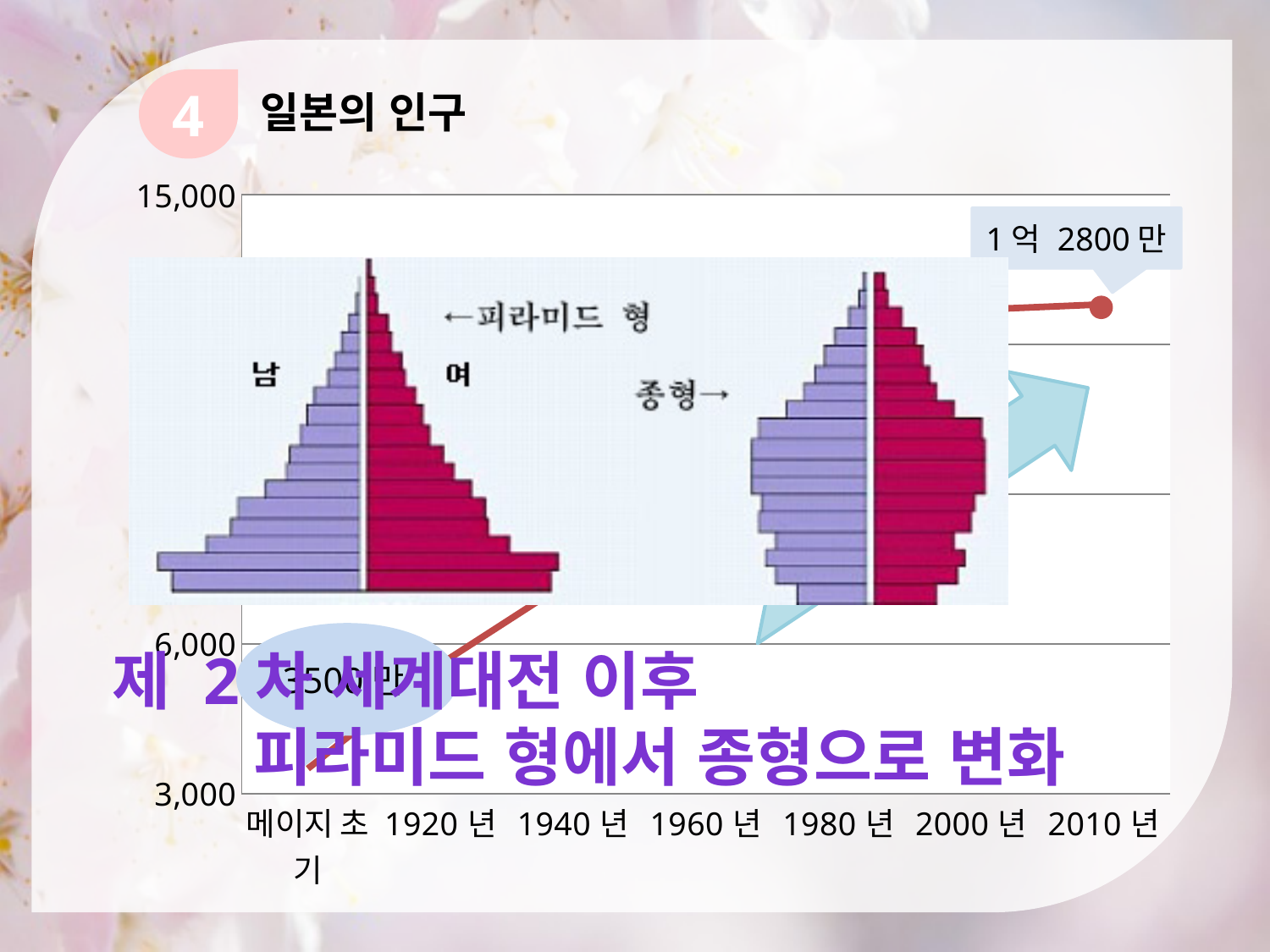
Is the value for 2010년 greater or less than 6,000? greater How many categories are shown on the x axis of the chart? 7 Which category has the lowest value? 메이지 초기 Do the values rise or fall from 메이지 초기 to 2010년? rise Which category has the highest value? 2010년 Is the value for 2010년 larger or smaller than the value for 메이지 초기? larger What is the first category on the x axis of the chart? 메이지 초기 What value does the callout give for 2010년? 1억 2800만 What is the title of the chart? 일본의 인구 What kind of chart is shown on the slide? line chart